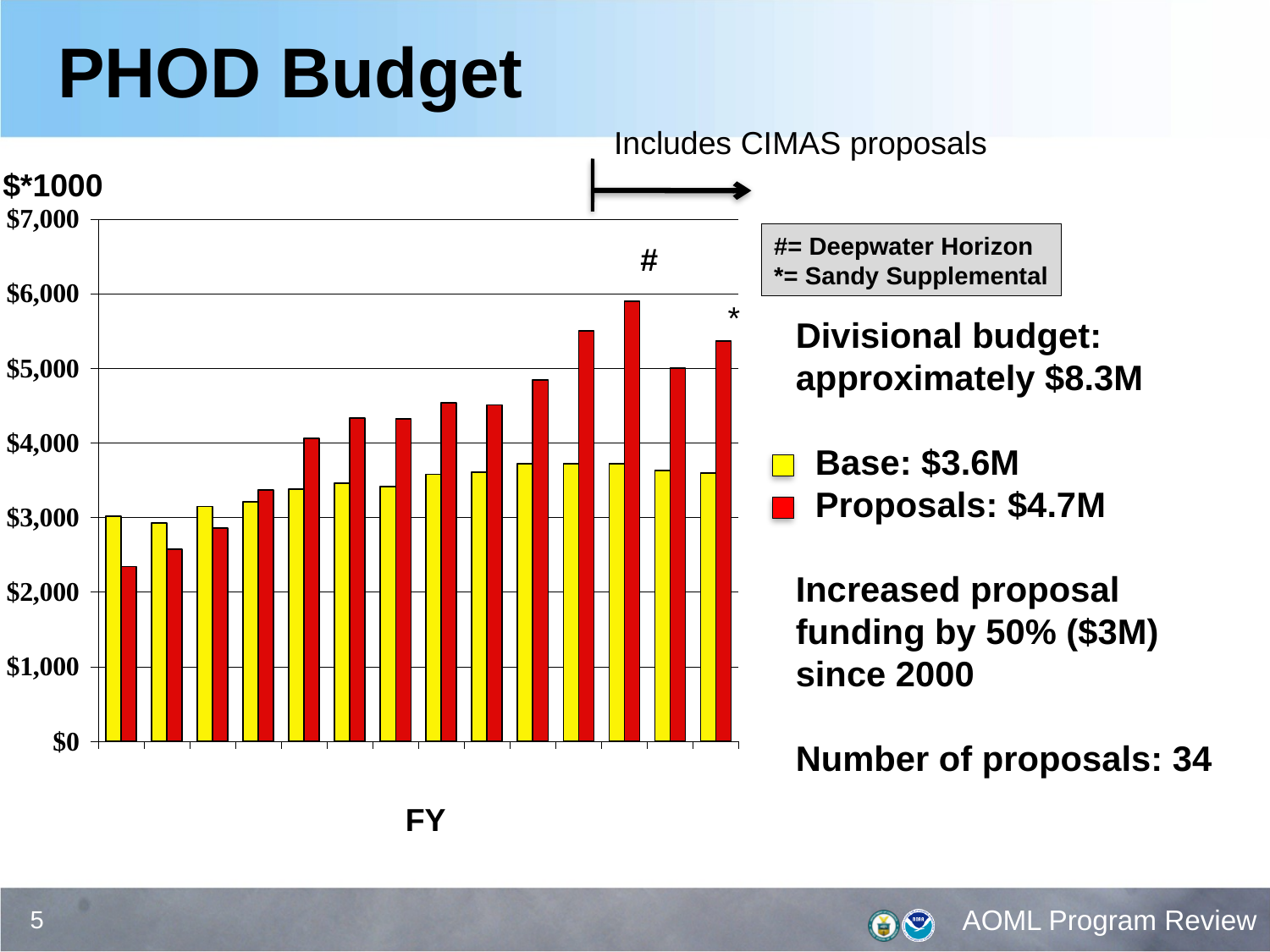
Is the red Proposals bar marked with # greater or less than $5,000? greater Is the yellow Base bar in the rightmost group greater or less than $4,000? less In the leftmost group, which bar is taller, the yellow Base bar or the red Proposals bar? the yellow Base bar How many series does the legend list for the chart? 2 What is the label on the x axis of the chart? FY In the rightmost group, which bar is taller, the yellow Base bar or the red Proposals bar? the red Proposals bar How many fiscal-year groups of bars are plotted in the chart? 14 Which series is drawn in red in the chart? Proposals Is the red Proposals bar in the leftmost group greater or less than $3,000? less Do the red Proposals bars generally rise or fall from left to right across the chart? rise What kind of chart is shown on the slide? bar chart Which red Proposals bar is the tallest in the chart? the bar marked #